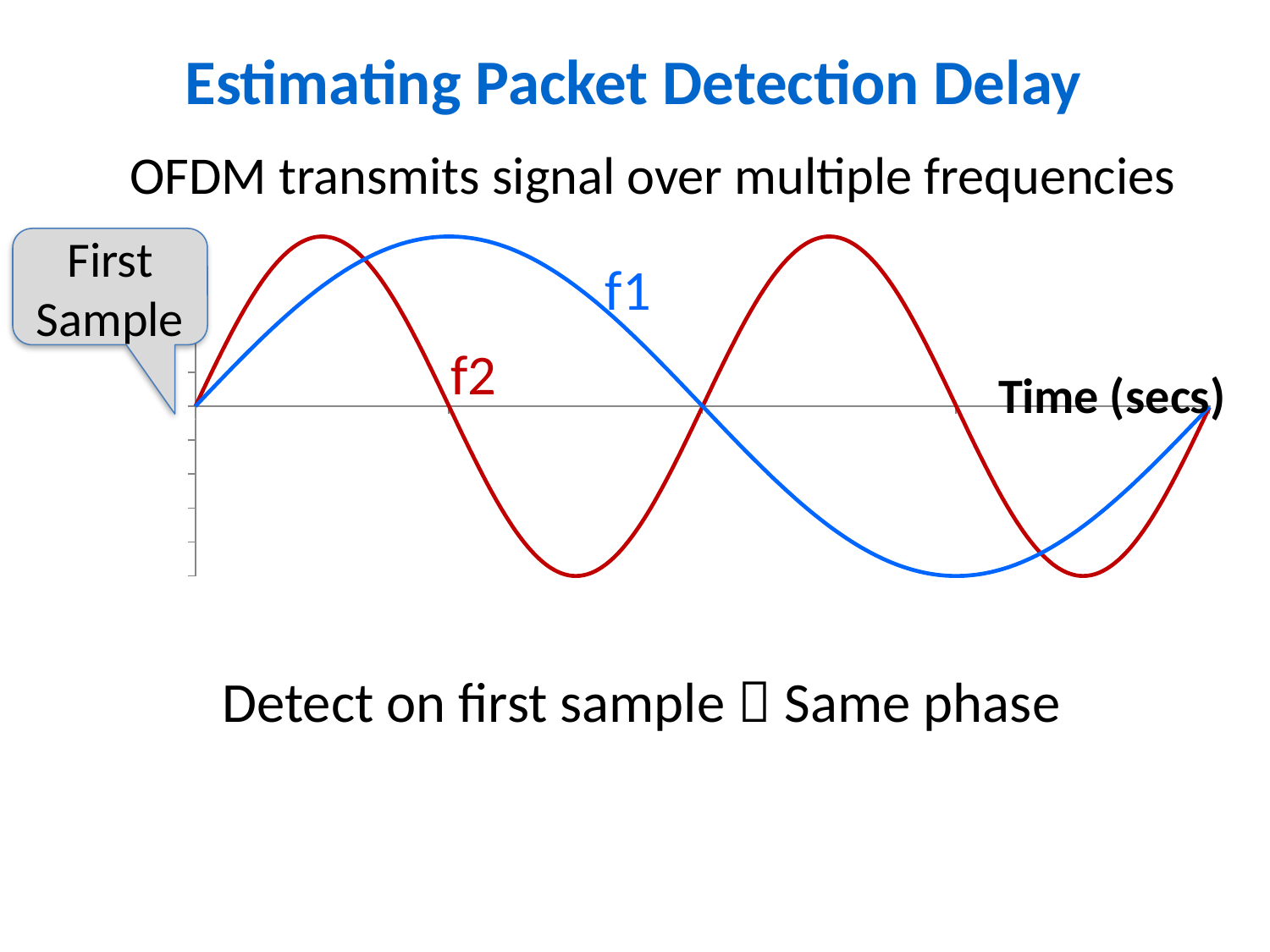
Which curve, f1 or f2, completes more cycles over the plotted time range? f2 What kind of chart is shown on the slide? line chart How many peaks (maxima) does the f1 curve have within the plotted range? 1 How many curves (series) are plotted on the chart? 2 How many peaks (maxima) does the f2 curve have within the plotted range? 2 What is the label on the horizontal axis of the chart? Time (secs) What colour is the curve labelled f1? blue Does the f2 curve rise or fall over the final portion of the chart, approaching the right edge? rise Does the f1 curve rise or fall immediately after the first sample at the left of the chart? rise